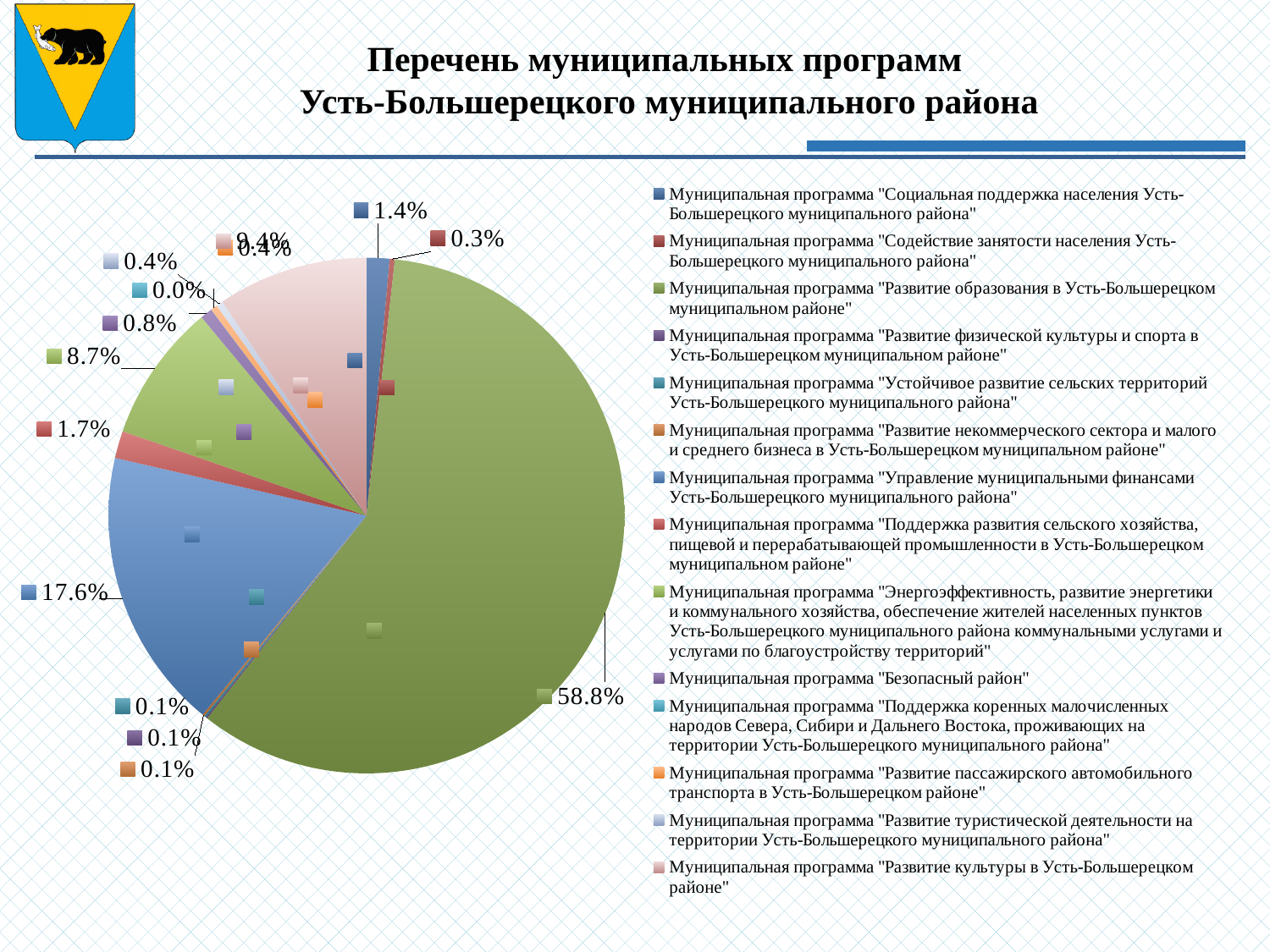
Which has the larger share: the municipal finances programme or the energy efficiency programme? the municipal finances programme What share does the programme "Социальная поддержка населения Усть-Большерецкого муниципального района" have? 1.4% What share does the programme "Поддержка развития сельского хозяйства, пищевой и перерабатывающей промышленности..." have? 1.7% What share does the programme "Энергоэффективность, развитие энергетики и коммунального хозяйства..." have? 8.7% How many municipal programmes are listed in the chart legend? 14 What type of chart is shown on the slide? pie chart What is the difference in percentage points between the education programme (58.8%) and the municipal finances programme (17.6%)? 41.2 Which programme has the largest share of the pie? Муниципальная программа "Развитие образования в Усть-Большерецком муниципальном районе"